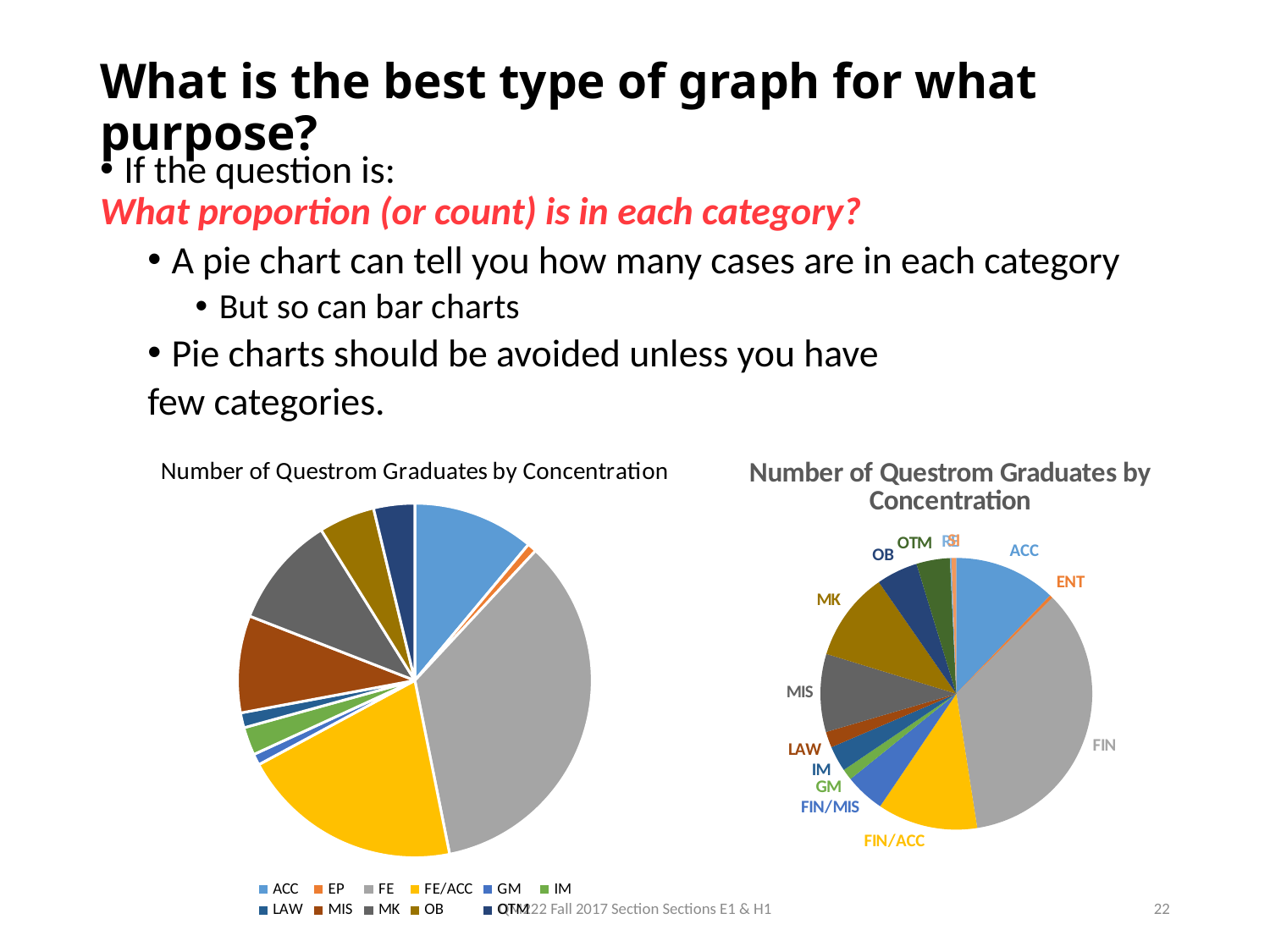
In the right-hand pie chart, which slice is larger, MIS or LAW? MIS In the right-hand pie chart, which concentration has the largest slice? FIN What type of chart is the chart on the right of the slide? pie chart In the right-hand pie chart, which slice is larger, FIN/ACC or MK? FIN/ACC In the right-hand pie chart, which slice is larger, FIN or ACC? FIN What type of chart is the chart on the left of the slide? pie chart Which of the two pie charts labels its slices directly on the chart instead of using a legend? the right-hand chart In the left-hand pie chart, which legend category has the largest slice? FE What is the title of the left-hand pie chart? Number of Questrom Graduates by Concentration